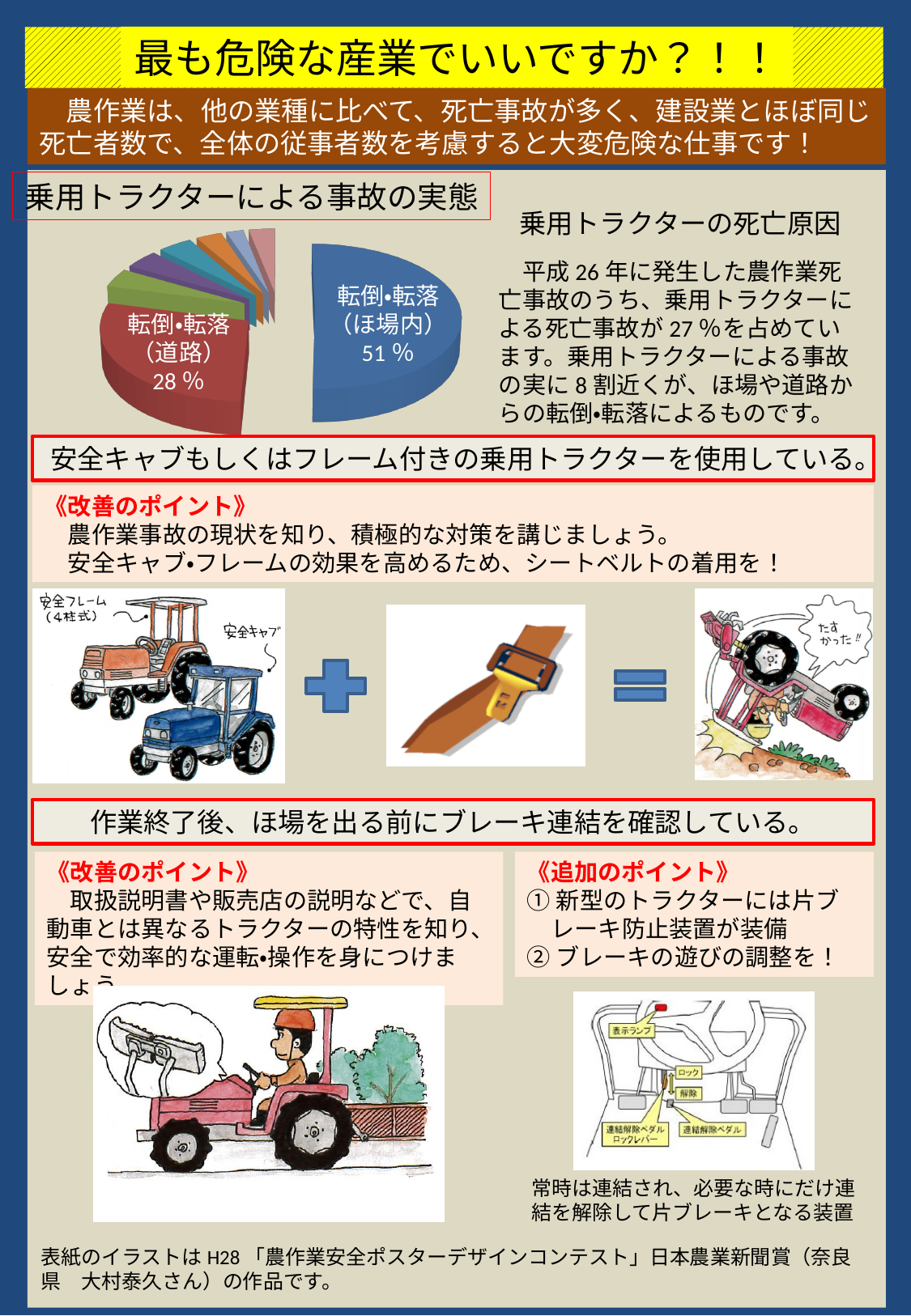
What share of the pie does 転倒・転落（道路） account for? 28% What kind of chart is shown on the slide? pie chart Is the share for 転倒・転落（ほ場内） greater or less than half of the pie? greater By how many percentage points does 転倒・転落（ほ場内） exceed 転倒・転落（道路）? 23 What share of the pie does 転倒・転落（ほ場内） account for? 51% Which is larger, the slice for 転倒・転落（ほ場内） or the slice for 転倒・転落（道路）? 転倒・転落（ほ場内） Which labeled slice of the pie chart is the largest? 転倒・転落（ほ場内） What colour is the slice labeled 転倒・転落（ほ場内）? blue What is the combined share of the two labeled slices, 転倒・転落（ほ場内） and 転倒・転落（道路）? 79%